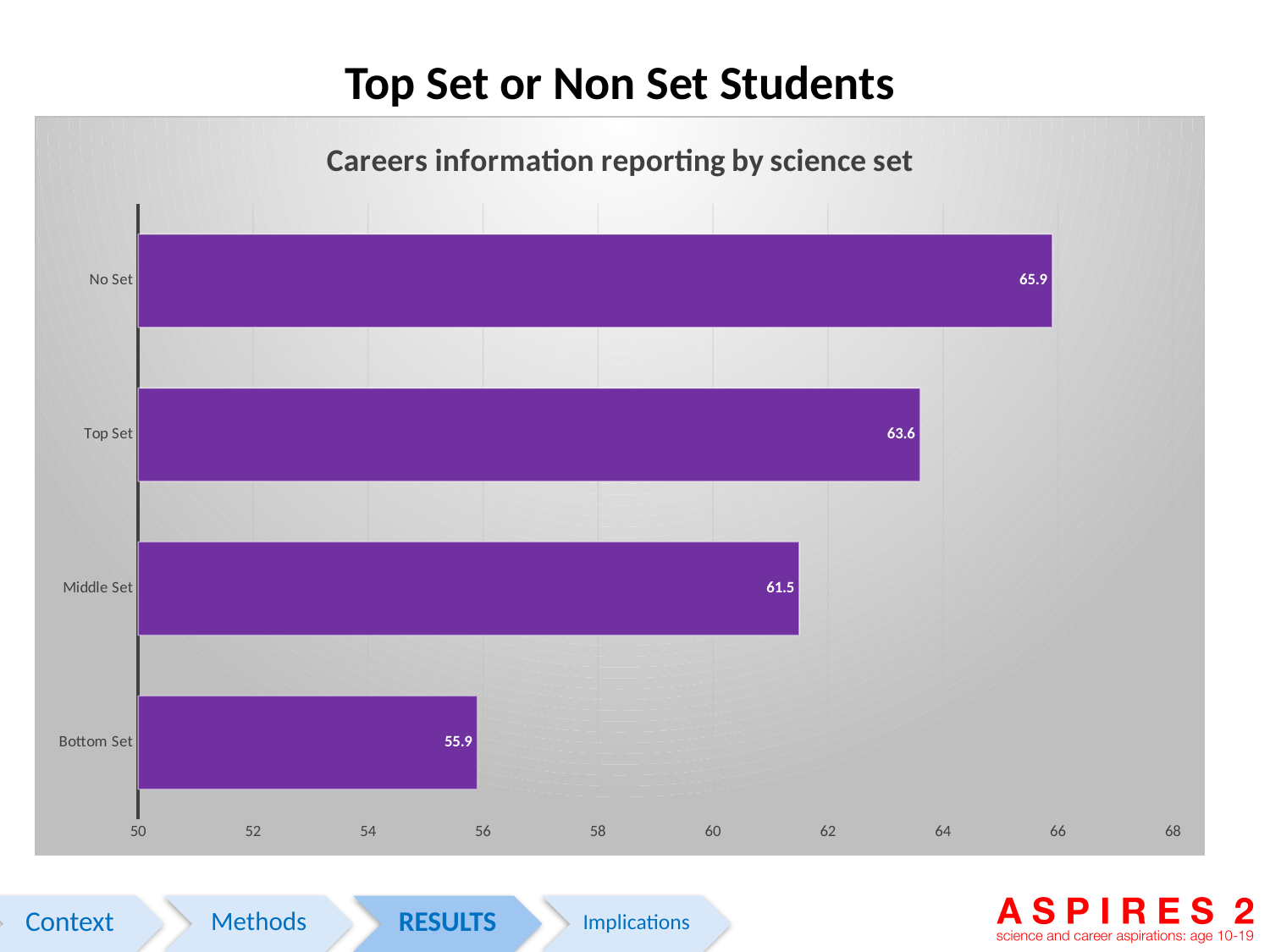
Which category has the lowest value? Bottom Set What is the value for Bottom Set? 55.9 What type of chart is shown? bar chart Is the value for Bottom Set greater or less than 56? less What is the difference between the values for No Set and Bottom Set? 10.0 How many categories are shown in the chart? 4 Which is larger, the value for Top Set or the value for Middle Set? Top Set Which category has the highest value? No Set What is the value for Middle Set? 61.5 What is the difference between the values for Top Set and Middle Set? 2.1 What is the value for Top Set? 63.6 What is the value for No Set? 65.9